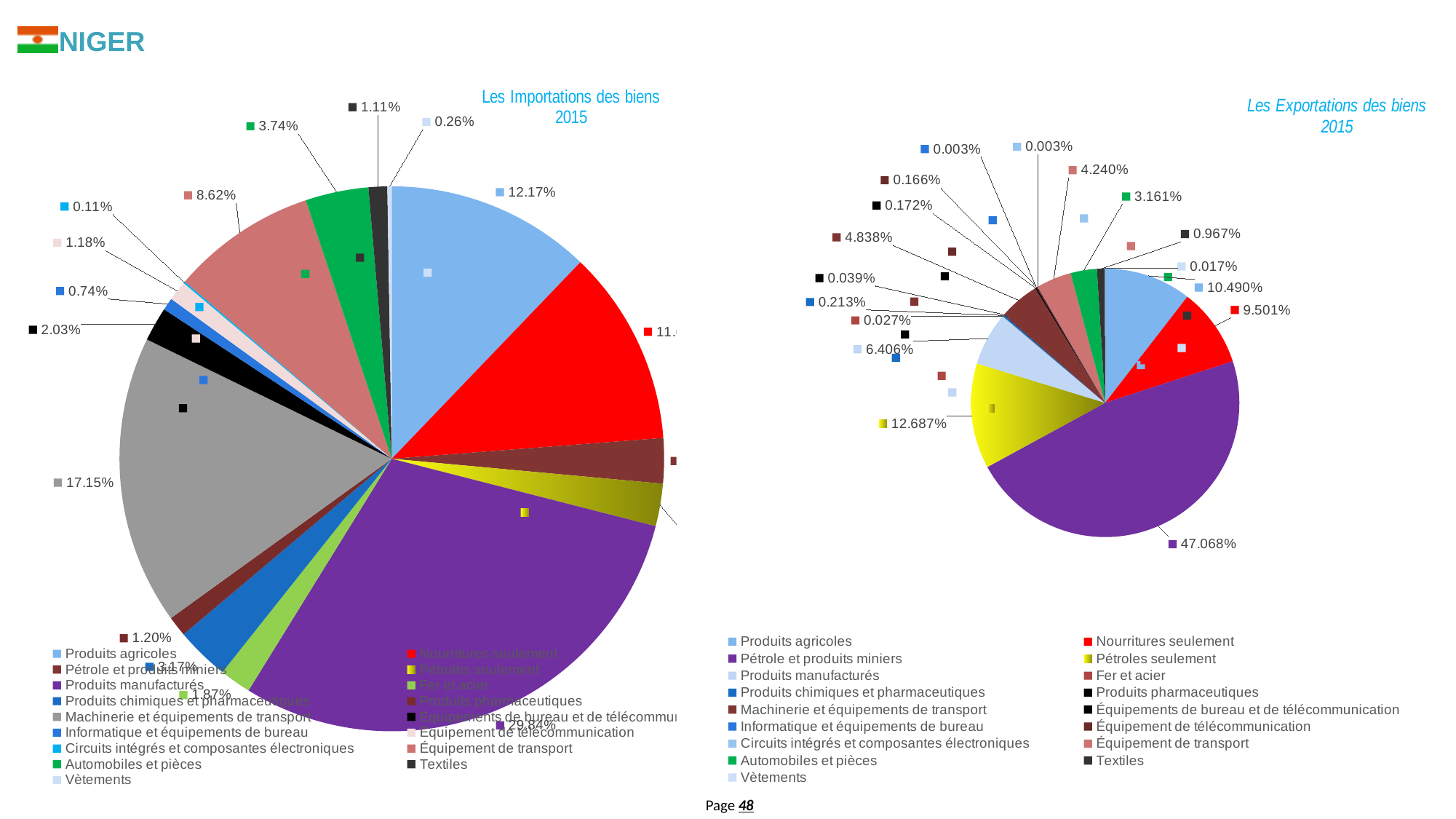
What kind of chart is 'Les Importations des biens 2015'? Pie chart In 'Les Importations des biens 2015', what is the share for Équipement de transport? 8.62% In 'Les Exportations des biens 2015', what is the share for Pétroles seulement? 12.687% How many categories does the legend of 'Les Exportations des biens 2015' list? 17 In 'Les Exportations des biens 2015', which is larger: Produits agricoles or Nourritures seulement? Produits agricoles In 'Les Importations des biens 2015', what is the share for Produits agricoles? 12.17% In 'Les Importations des biens 2015', which category has the largest share? Produits manufacturés In 'Les Exportations des biens 2015', what is the difference between the shares of Pétrole et produits miniers and Pétroles seulement? 34.381% In 'Les Exportations des biens 2015', what is the share for Nourritures seulement? 9.501% In 'Les Importations des biens 2015', what is the share for Machinerie et équipements de transport? 17.15% In 'Les Importations des biens 2015', what is the difference between the shares of Produits manufacturés and Machinerie et équipements de transport? 12.69% In 'Les Exportations des biens 2015', which category has the largest share? Pétrole et produits miniers